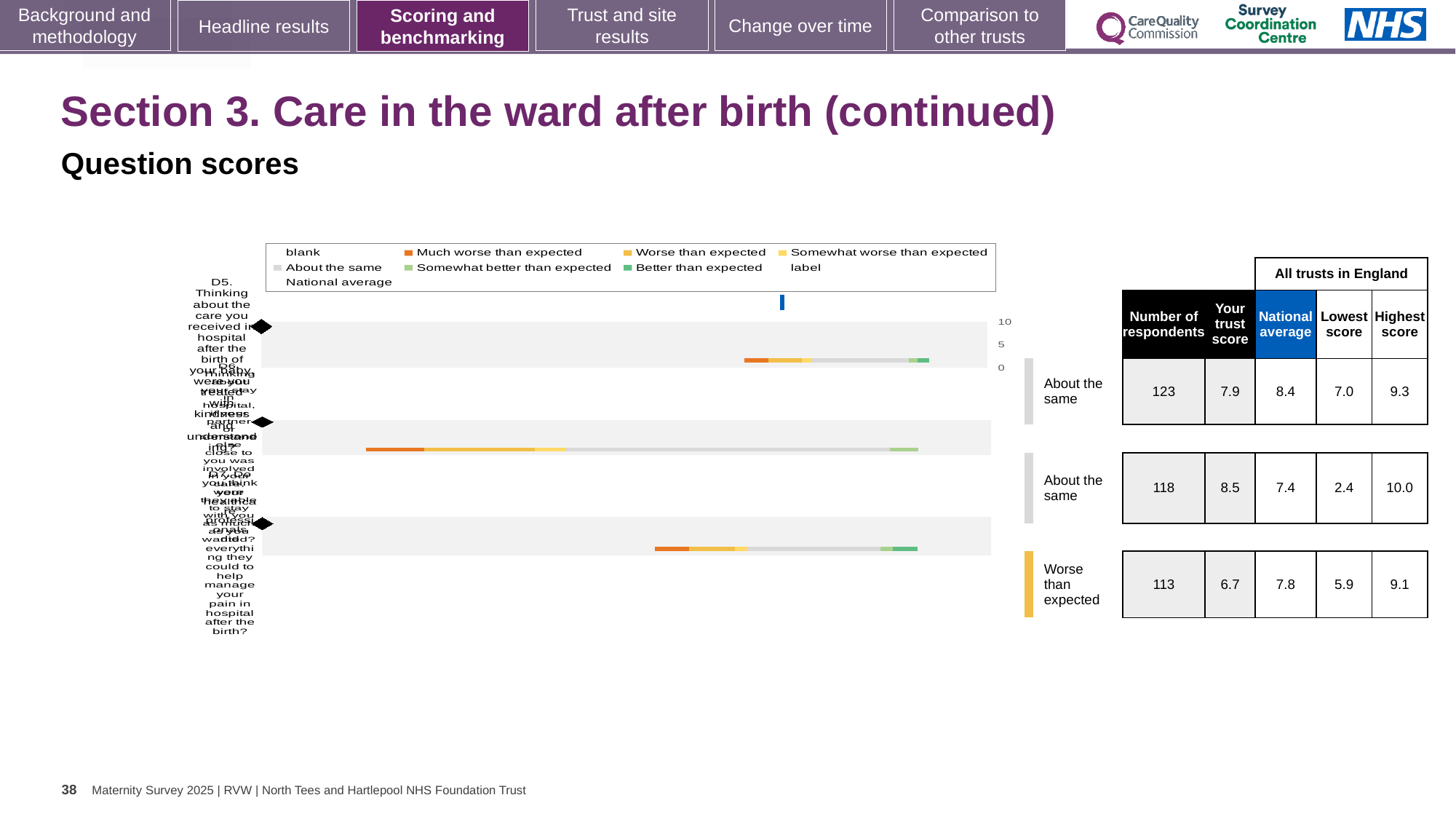
What colour represents 'Much worse than expected' in the chart legend? orange What is the difference between the highest score and the lowest score in the second row of the table? 7.6 In the table, what is the 'Your trust score' for the second row? 8.5 What benchmark label is shown next to the third row of the chart? Worse than expected In the table, what is the number of respondents for the first row? 123 In the table, what is the national average for the third row? 7.8 How many question rows are shown in the chart and table? 3 In the first row of the table, which is larger: the trust score or the national average? the national average (8.4) What kind of chart is shown on the slide? bar chart Which row has the lowest number of respondents in the table? the third row (113) In the table, what is the highest score for the second row? 10.0 Which row has the highest 'Your trust score' in the table? the second row (8.5)